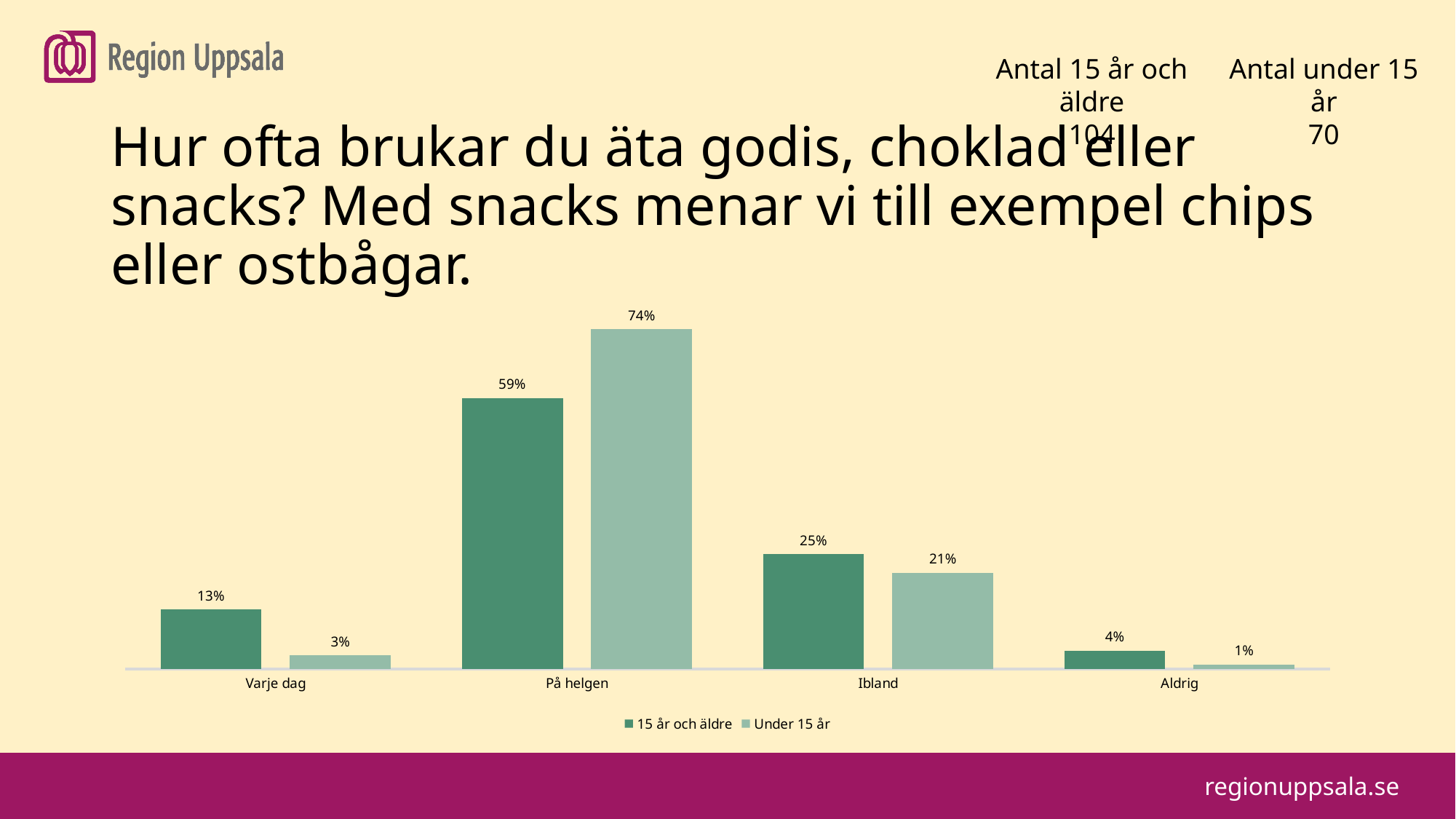
Which category has the lowest value for the "15 år och äldre" series? Aldrig What is the difference between the "Under 15 år" and "15 år och äldre" values in the "På helgen" category? 15% How many categories are shown on the x axis? 4 What is the value for "15 år och äldre" in the "Aldrig" category? 4% What is the value for "15 år och äldre" in the "På helgen" category? 59% What is the value for "Under 15 år" in the "Varje dag" category? 3% Which category has the highest value for the "Under 15 år" series? På helgen What are the two series names listed in the legend? 15 år och äldre; Under 15 år In the "Ibland" category, which series has the larger value: "15 år och äldre" or "Under 15 år"? 15 år och äldre What kind of chart is shown on the slide? Bar chart What is the value for "Under 15 år" in the "Ibland" category? 21% How many series does the legend list? 2